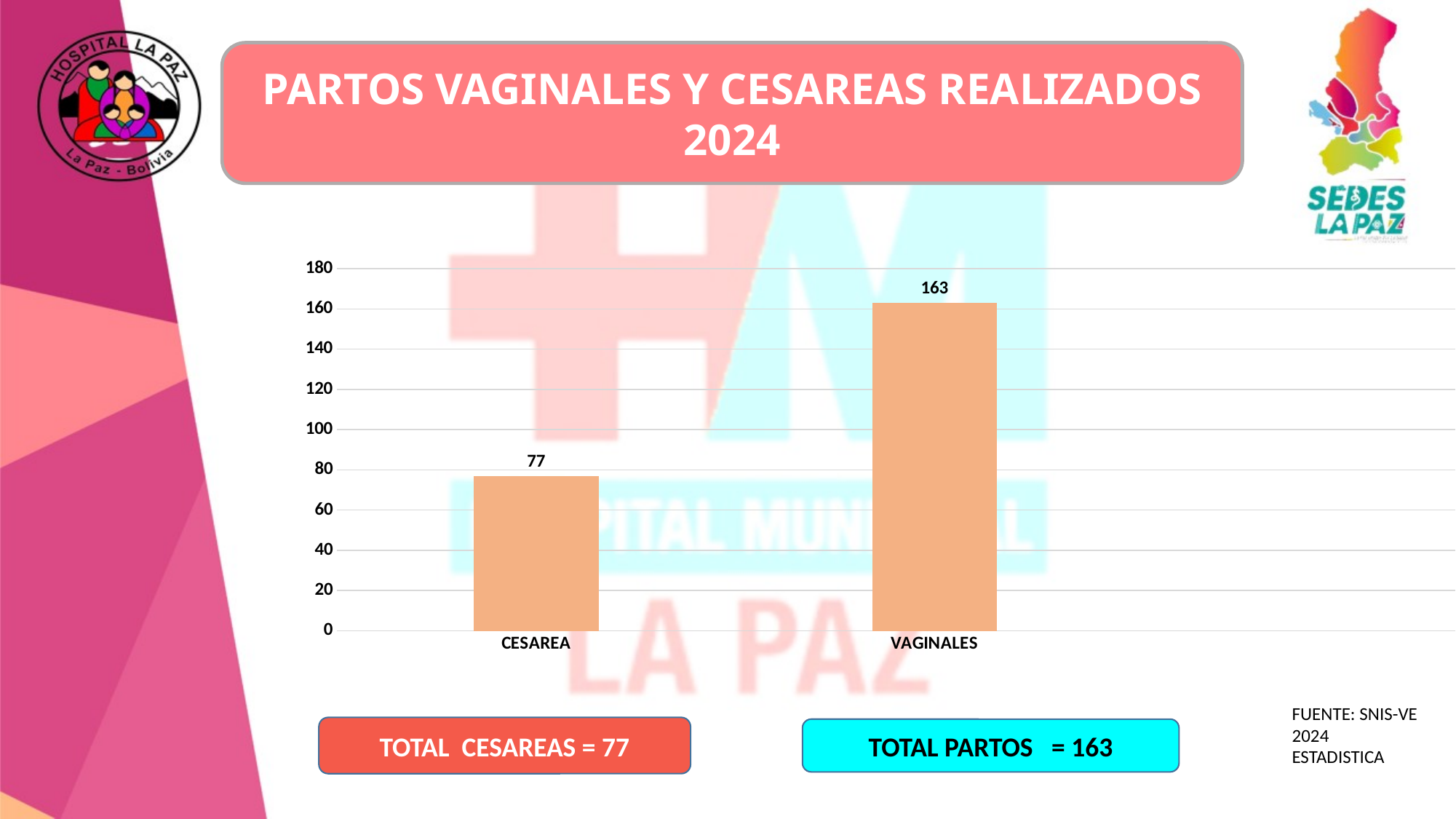
Which category has the lowest value? CESAREA What is the value for CESAREA? 77 What kind of chart is shown on the slide? bar chart Is the value for VAGINALES greater or less than 140? greater Which is larger, the value for CESAREA or the value for VAGINALES? VAGINALES What is the highest value shown on the vertical axis? 180 Which category has the highest value? VAGINALES What is the value for VAGINALES? 163 Is the value for CESAREA greater or less than 100? less How many categories are shown on the x axis? 2 What is the title of the slide containing the chart? PARTOS VAGINALES Y CESAREAS REALIZADOS 2024 What is the difference between the values for VAGINALES and CESAREA? 86